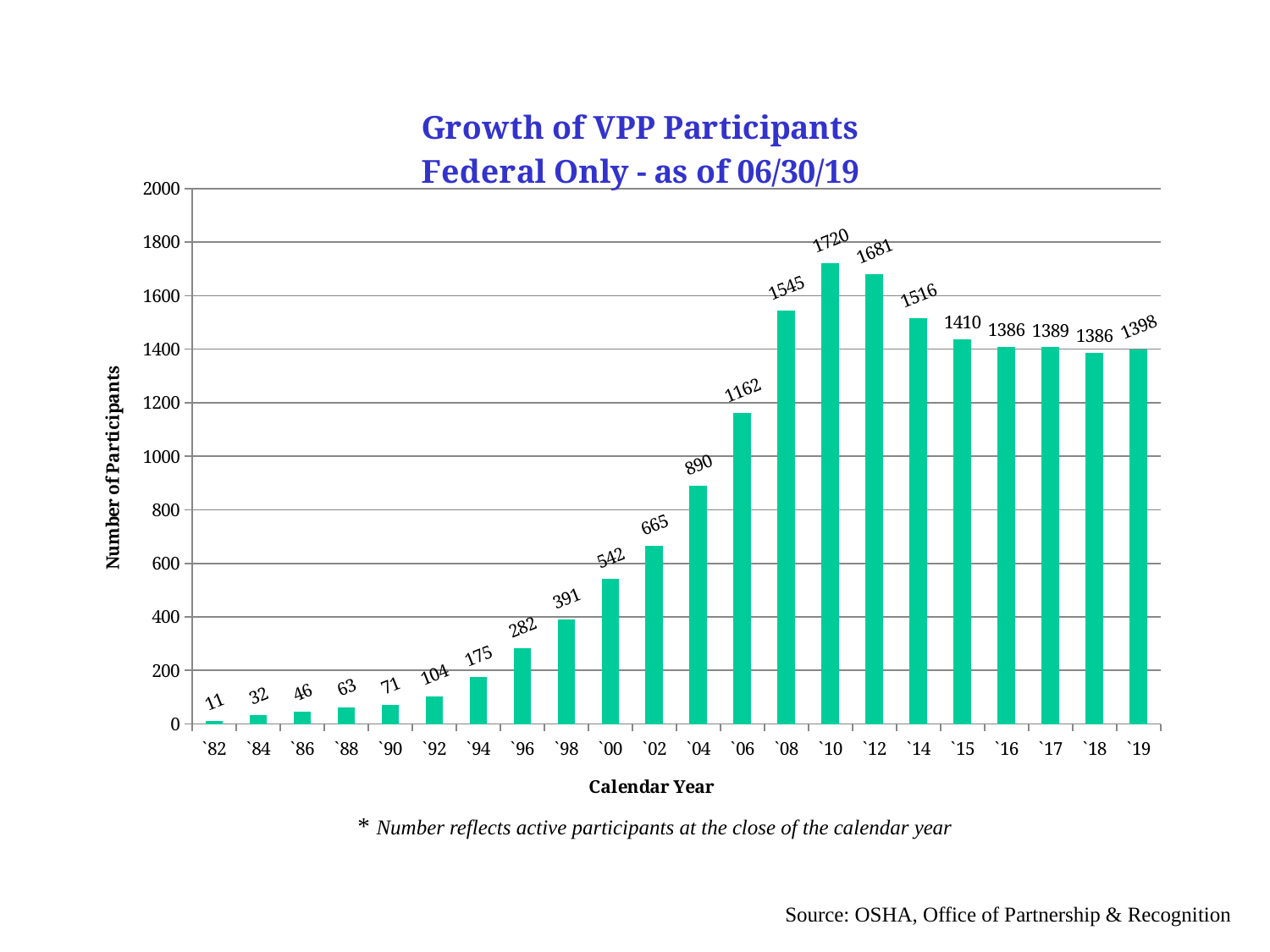
How many calendar years are shown on the x axis? 22 What is the number of participants for `00? 542 Which has more participants, `14 or `15? `14 Which calendar year has the highest number of participants? `10 What is the difference in participants between `10 and `12? 39 What is the number of participants for `10? 1720 What is the difference in participants between `08 and `06? 383 Is the value for `04 greater or less than 800? greater Which calendar year has the lowest number of participants? `82 What kind of chart is shown on the slide? bar chart What is the number of participants for `19? 1398 Do the values rise or fall from `82 to `10? rise